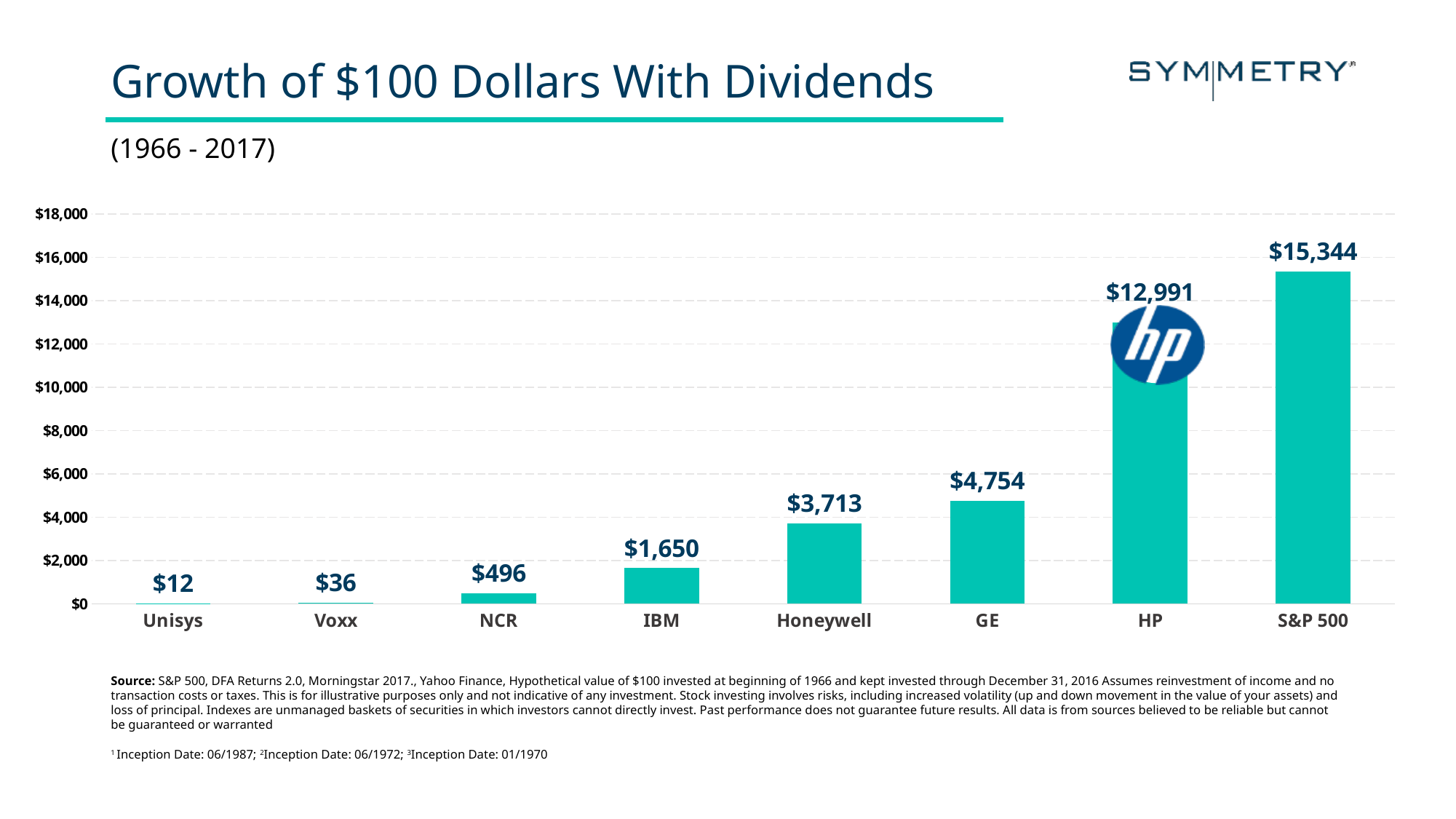
Which category has the lowest value? Unisys What is the difference between the S&P 500 value and the HP value? $2,353 Do the values rise or fall from left to right along the x axis? rise Which is larger, the value for NCR or the value for Voxx? NCR Which category has the highest value? S&P 500 What is the value shown for Unisys? $12 What is the value shown for Honeywell? $3,713 What kind of chart is shown on the slide? bar chart How many categories are shown on the x axis? 8 What is the value shown for the S&P 500? $15,344 Is the value for HP greater or less than $12,000? greater What is the difference between the GE value and the IBM value? $3,104